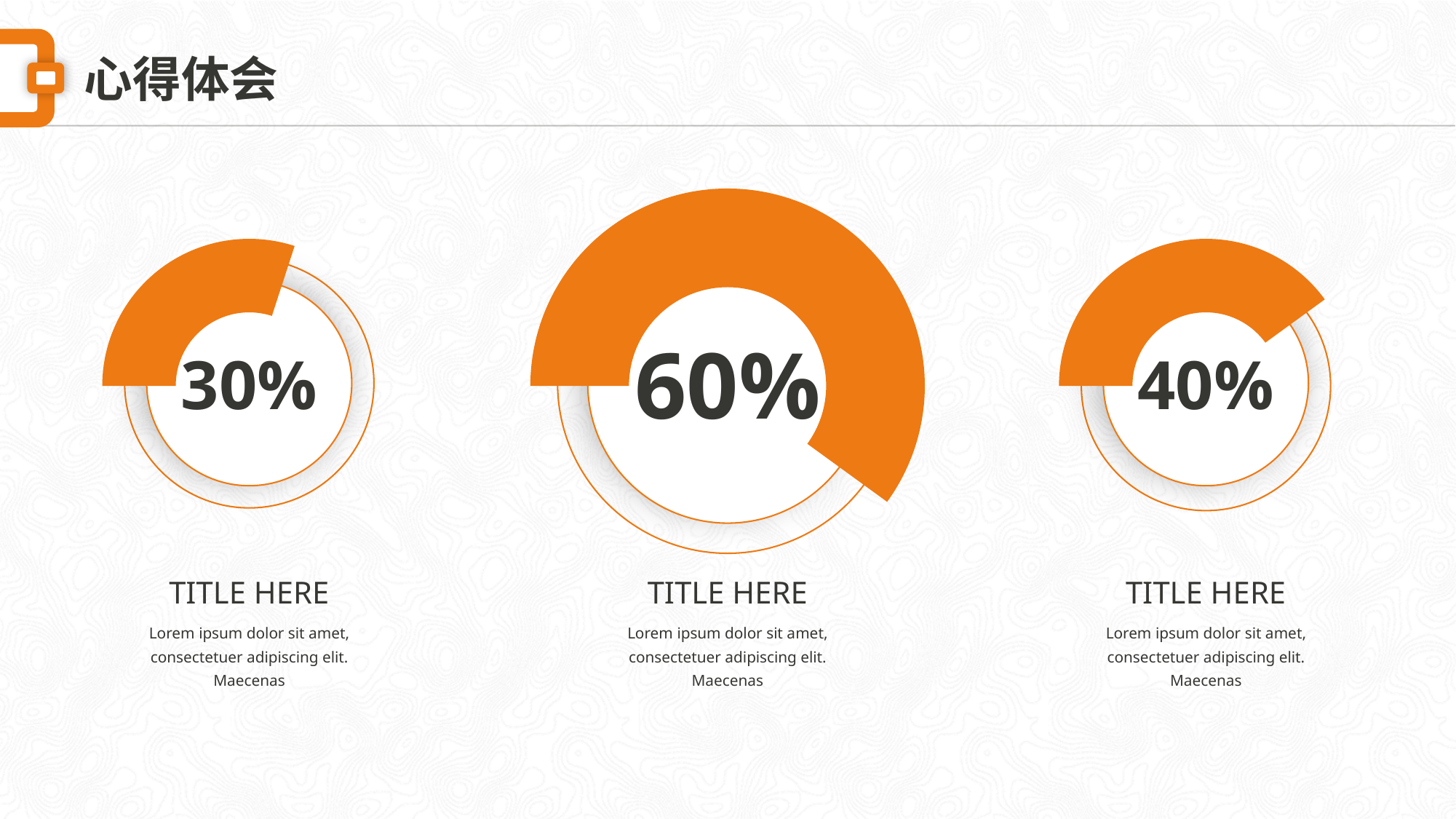
What colour is the filled portion of each donut chart? orange How many percentage charts are on the slide? 3 Which is larger, the percentage in the right chart or the percentage in the left chart? right chart Which of the three charts shows the highest percentage: left, middle or right? middle What percentage is shown in the middle chart? 60% What percentage is shown in the right chart? 40% Is the percentage in the middle chart greater or less than 50%? greater What percentage is shown in the left chart? 30% What kind of chart is used to display each percentage on the slide? donut chart What is the difference between the percentage in the middle chart and the percentage in the left chart? 30% What is the difference between the percentage in the right chart and the percentage in the left chart? 10% Which of the three charts shows the lowest percentage: left, middle or right? left